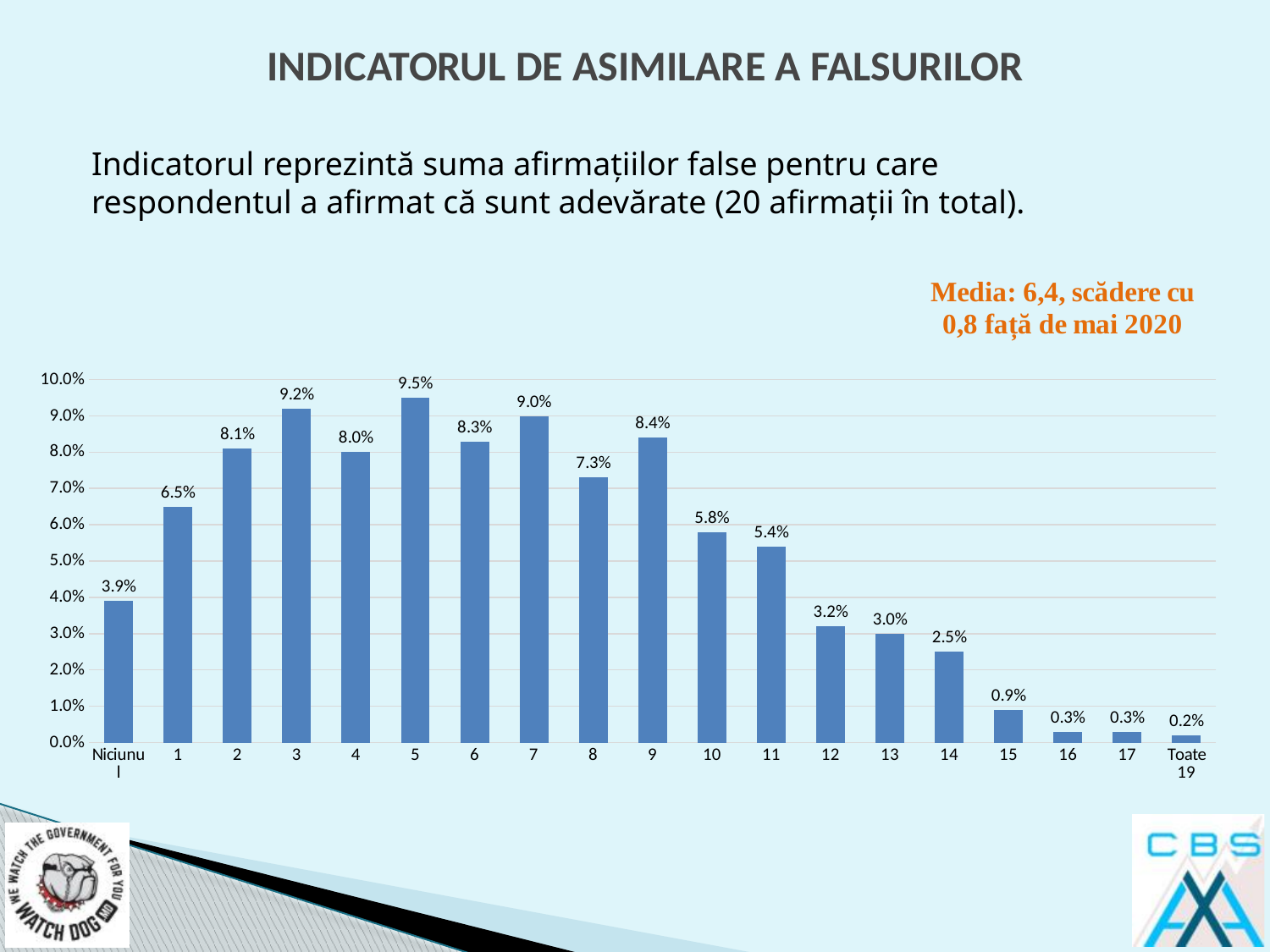
Which category has the lowest value? Toate 19 Which category has the highest value? 5 Do the values rise or fall from category 10 to category 17? fall What is the value for the category "Niciunul"? 3.9% What is the value for the category "Toate 19"? 0.2% What is the value for category 5? 9.5% What is the value for category 10? 5.8% What is the difference between the values for category 3 and category 4? 1.2% How many categories are shown on the x axis? 19 Is the value for category 12 greater or less than 4.0%? less What kind of chart is shown on the slide? bar chart Which is larger, the value for category 7 or the value for category 9? 7